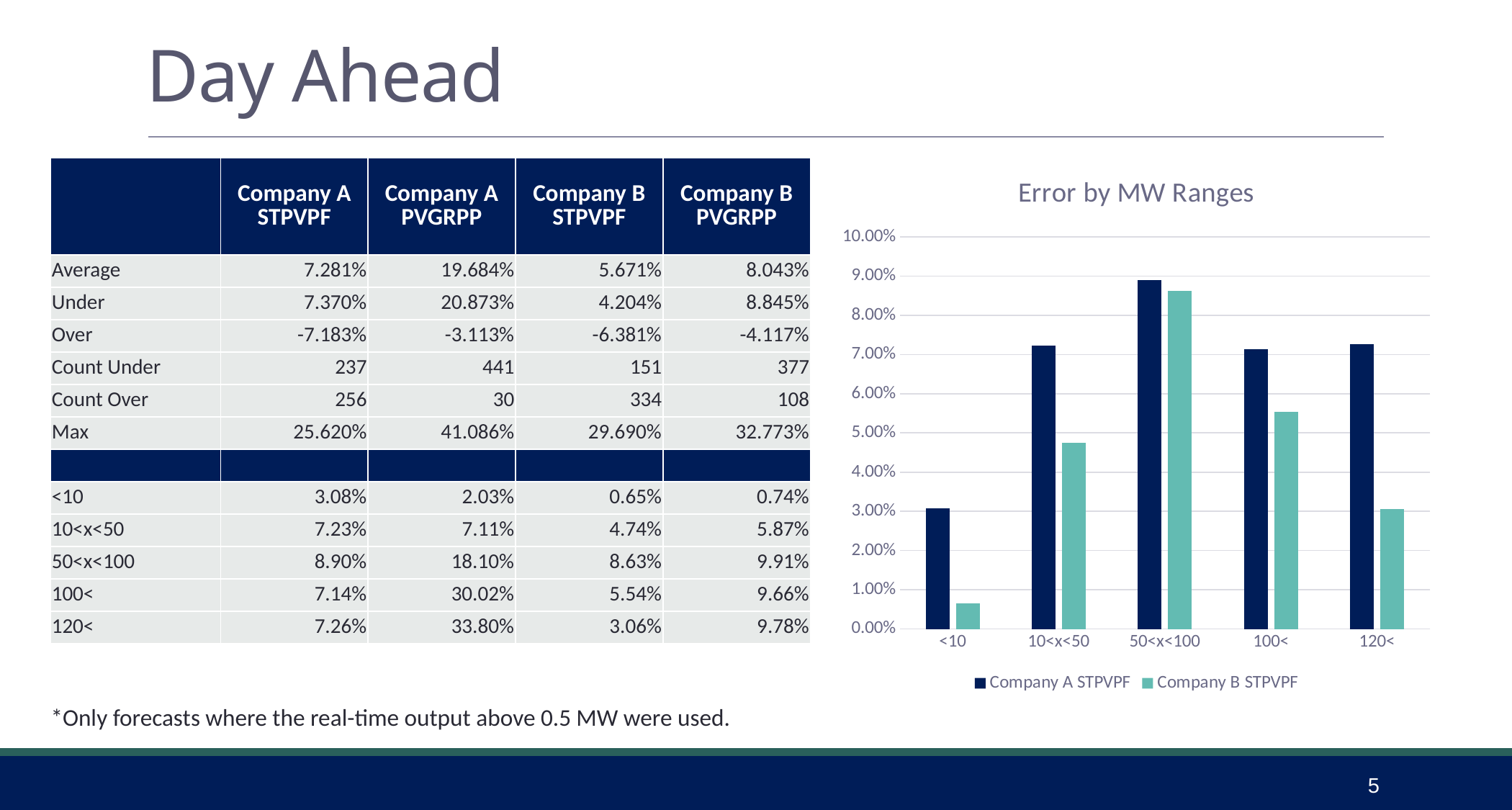
Using the table values, what is the difference between Company A STPVPF and Company B STPVPF for the 120< range? 4.20% Does the Company B STPVPF error rise or fall from the 50<x<100 range to the 120< range? fall What is the title of the chart? Error by MW Ranges According to the table, what is the Company A STPVPF error for the 100< range? 7.14% Is the Company B STPVPF value for the 120< range greater or less than 4.00%? less Is the Company A STPVPF value for the <10 range greater or less than 2.00%? greater In which MW range is the Company A STPVPF error highest? 50<x<100 How many series does the legend of the 'Error by MW Ranges' chart list? 2 How many MW range categories are shown on the x axis of the chart? 5 For the 10<x<50 range, which series has the larger error, Company A STPVPF or Company B STPVPF? Company A STPVPF What kind of chart is shown on the slide? bar chart In which MW range is the Company B STPVPF error lowest? <10